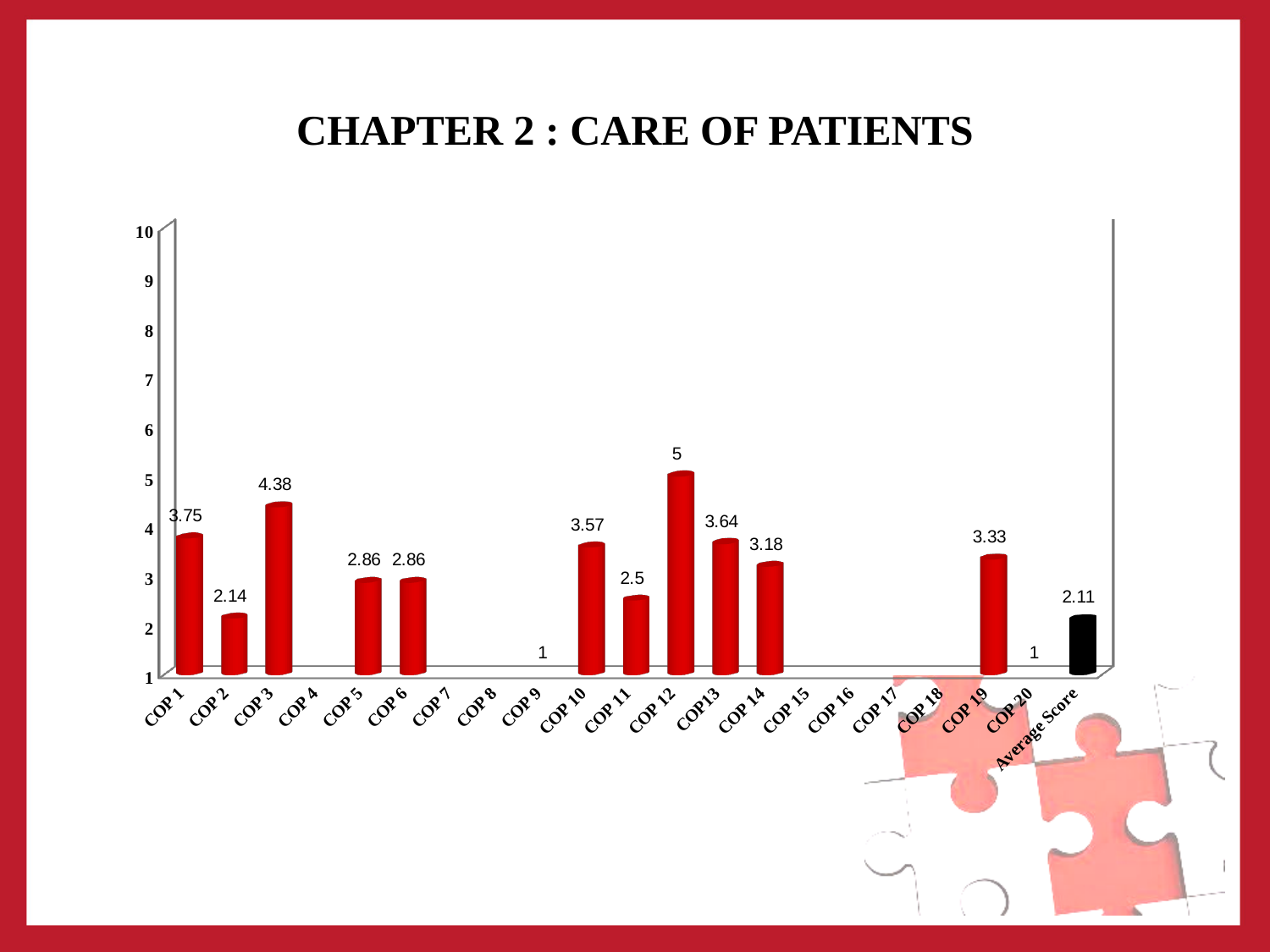
Which is larger, the value for COP 1 or the value for COP13? COP 1 What is the difference between the values for COP 12 and COP 3? 0.62 Is the value for COP 19 greater or less than 3? greater What is the difference between the values for COP 1 and COP 2? 1.61 Which category has the highest value? COP 12 What is the Average Score shown on the chart? 2.11 How many categories are labelled on the x axis? 21 What is the value for COP 20? 1 What is the value for COP 3? 4.38 What is the title of the slide? CHAPTER 2 : CARE OF PATIENTS What kind of chart is shown on the slide? bar chart What is the value for COP 12? 5